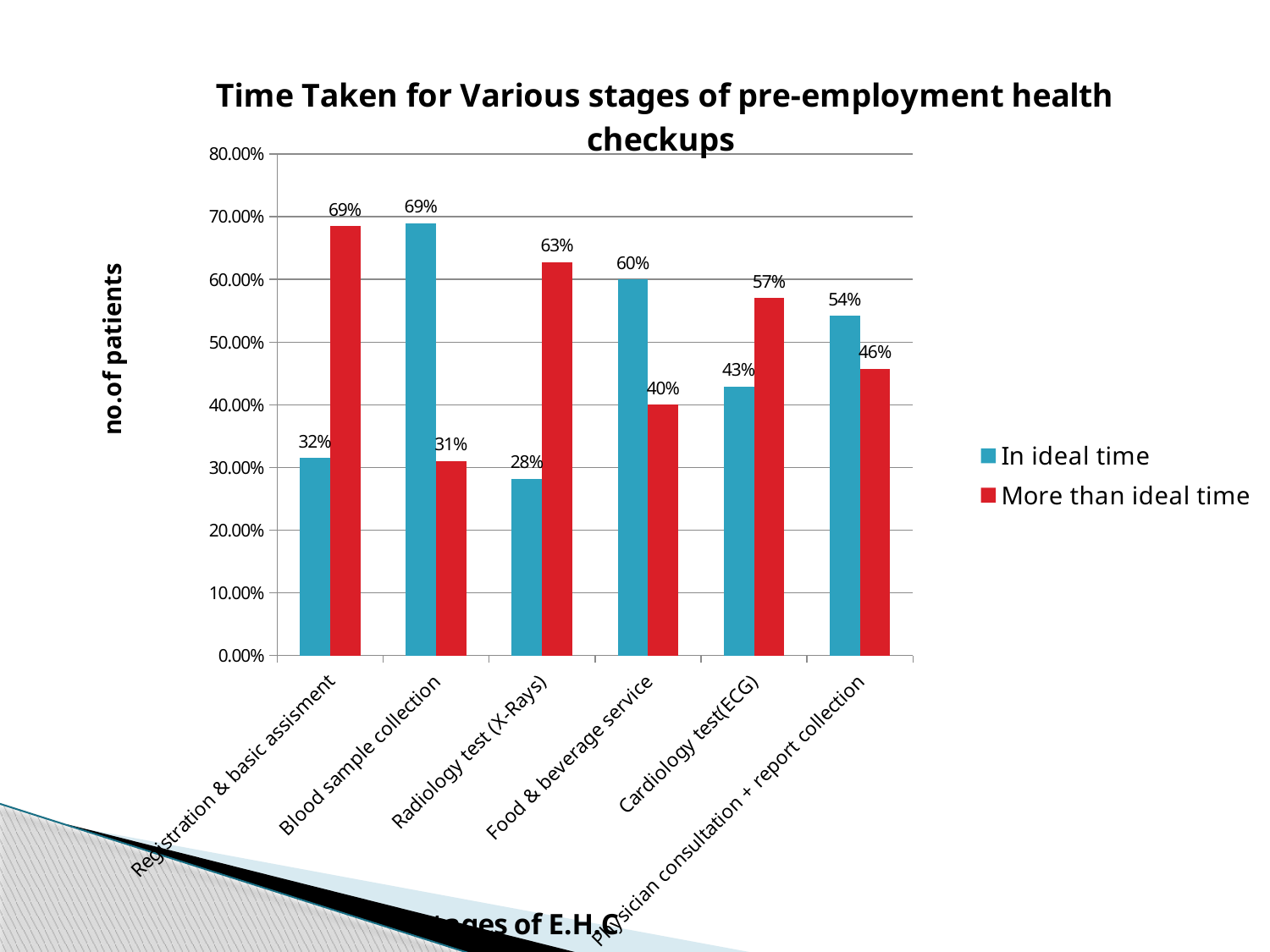
Which stage has the lowest 'More than ideal time' value? Blood sample collection What is the 'In ideal time' value for Blood sample collection? 69% What is the 'In ideal time' value for Physician consultation + report collection? 54% What is the 'More than ideal time' value for Radiology test (X-Rays)? 63% For Cardiology test(ECG), which is larger: 'In ideal time' or 'More than ideal time'? More than ideal time What is the title of the chart? Time Taken for Various stages of pre-employment health checkups How many stages (categories) are shown on the x axis? 6 Which stage has the highest 'More than ideal time' value? Registration & basic assisment What is the difference between the 'More than ideal time' and 'In ideal time' values for Registration & basic assisment? 37 percentage points Which stage has the lowest 'In ideal time' value? Radiology test (X-Rays) How many series does the legend list? 2 What kind of chart is shown on the slide? Bar chart